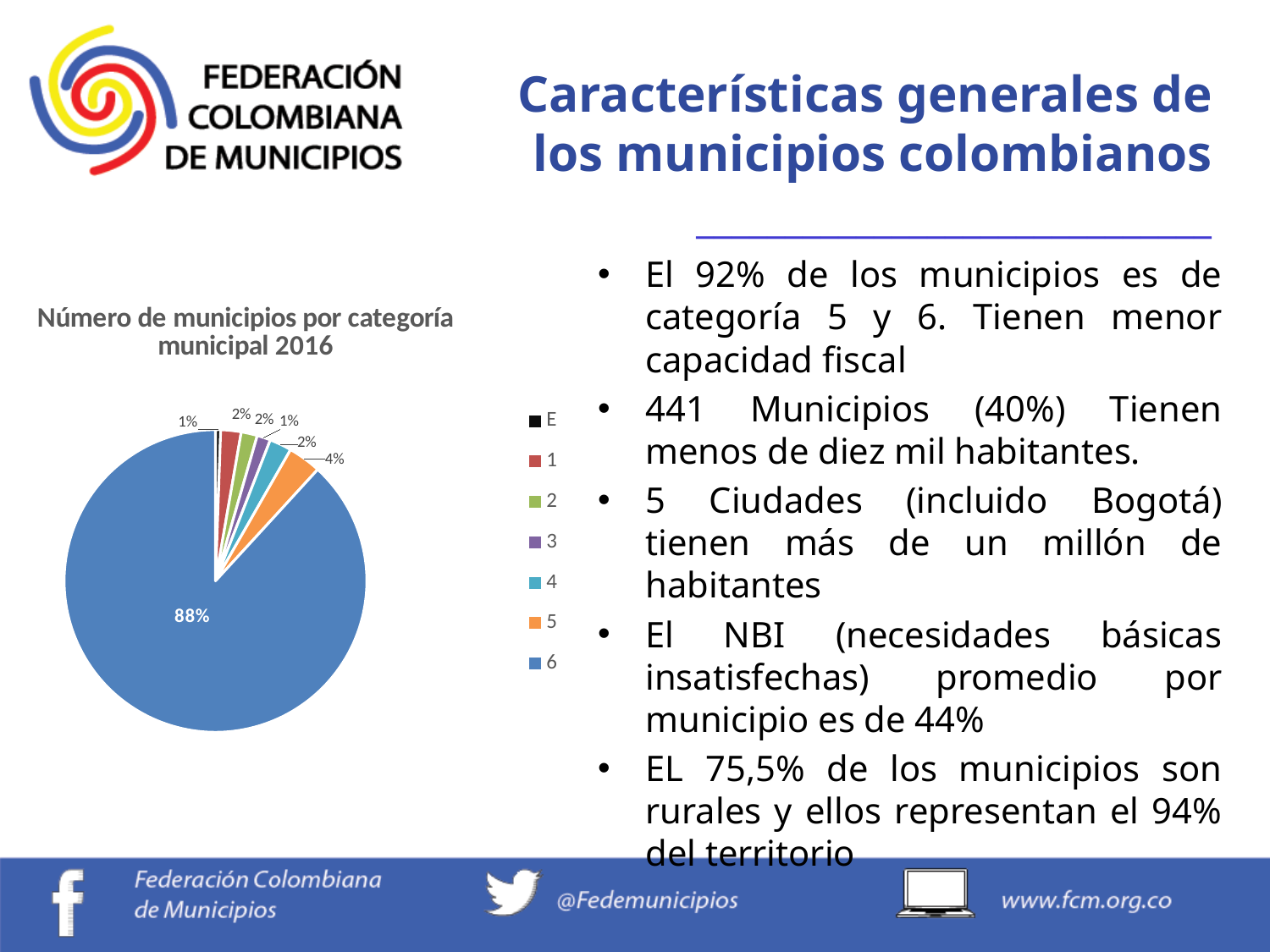
What is the combined share of categories 5 and 6? 92% Is the share for category 6 greater or less than 50%? greater What kind of chart is shown on the slide? pie chart What colour represents category 6 in the pie chart? blue What is the title of the chart? Número de municipios por categoría municipal 2016 What percentage of municipalities is in category 6? 88% What is the difference in percentage points between category 6 and category 5? 84% What percentage of municipalities is in category E? 1% How many categories does the legend list? 7 Which category has the largest share of the pie? 6 Which has a larger share, category 5 or category 6? 6 What percentage of municipalities is in category 5? 4%